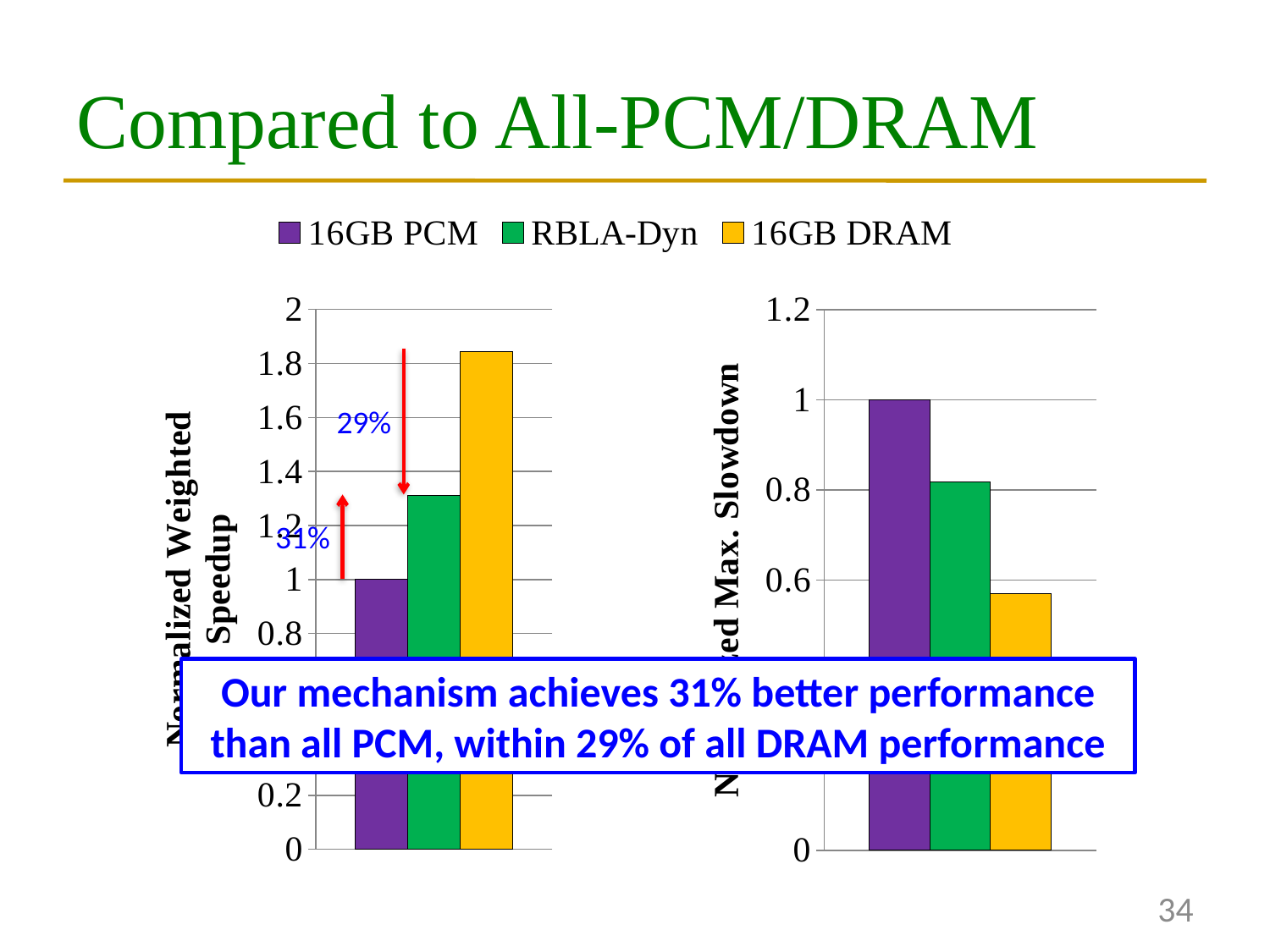
In the left chart (Normalized Weighted Speedup), which is larger, RBLA-Dyn or 16GB DRAM? 16GB DRAM In the left chart (Normalized Weighted Speedup), which series has the lowest value? 16GB PCM What colour represents RBLA-Dyn in the legend? green In the right chart, which series has the lowest value? 16GB DRAM What kind of chart is the left chart (Normalized Weighted Speedup)? bar chart In the left chart (Normalized Weighted Speedup), is the value for 16GB DRAM greater or less than 1.6? greater In the right chart, is the value for 16GB DRAM greater or less than 0.8? less In the left chart (Normalized Weighted Speedup), what is the value for 16GB PCM? 1 In the left chart (Normalized Weighted Speedup), is the value for RBLA-Dyn greater or less than 1.2? greater How many series does the legend list? 3 In the left chart (Normalized Weighted Speedup), which series has the highest value? 16GB DRAM In the right chart, what is the value for 16GB PCM? 1